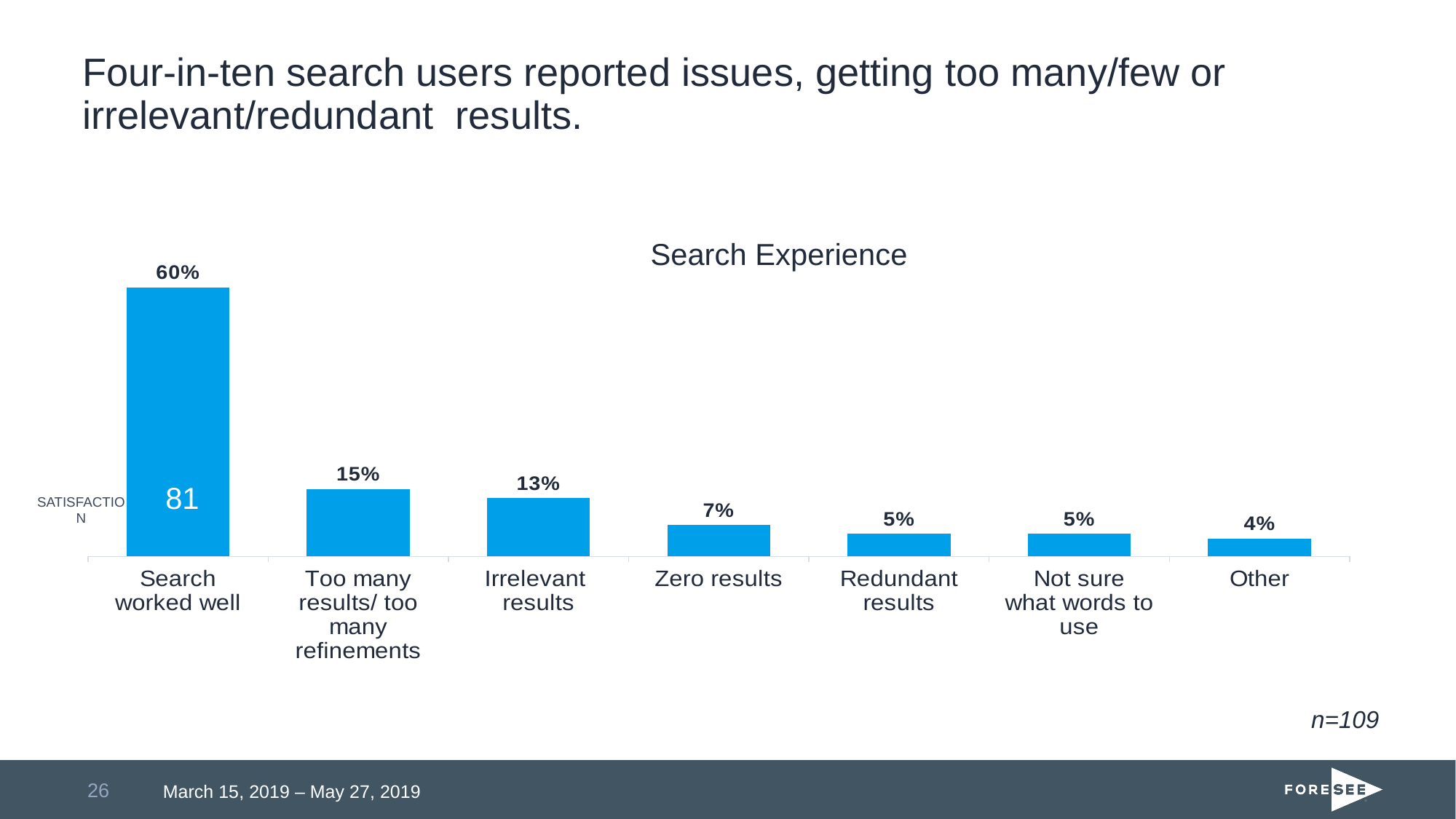
What percentage of search users said search worked well? 60% Which category has the highest value? Search worked well What is the difference between 'Search worked well' and 'Too many results/ too many refinements'? 45% What is the value for 'Too many results/ too many refinements'? 15% How many categories are shown in the chart? 7 What type of chart is shown? Bar chart What is the value for 'Zero results'? 7% Which is larger, 'Irrelevant results' or 'Zero results'? Irrelevant results Which category has the lowest value? Other What percentage of users selected 'Other'? 4% What percentage of users reported irrelevant results? 13% What is the title of the chart? Search Experience